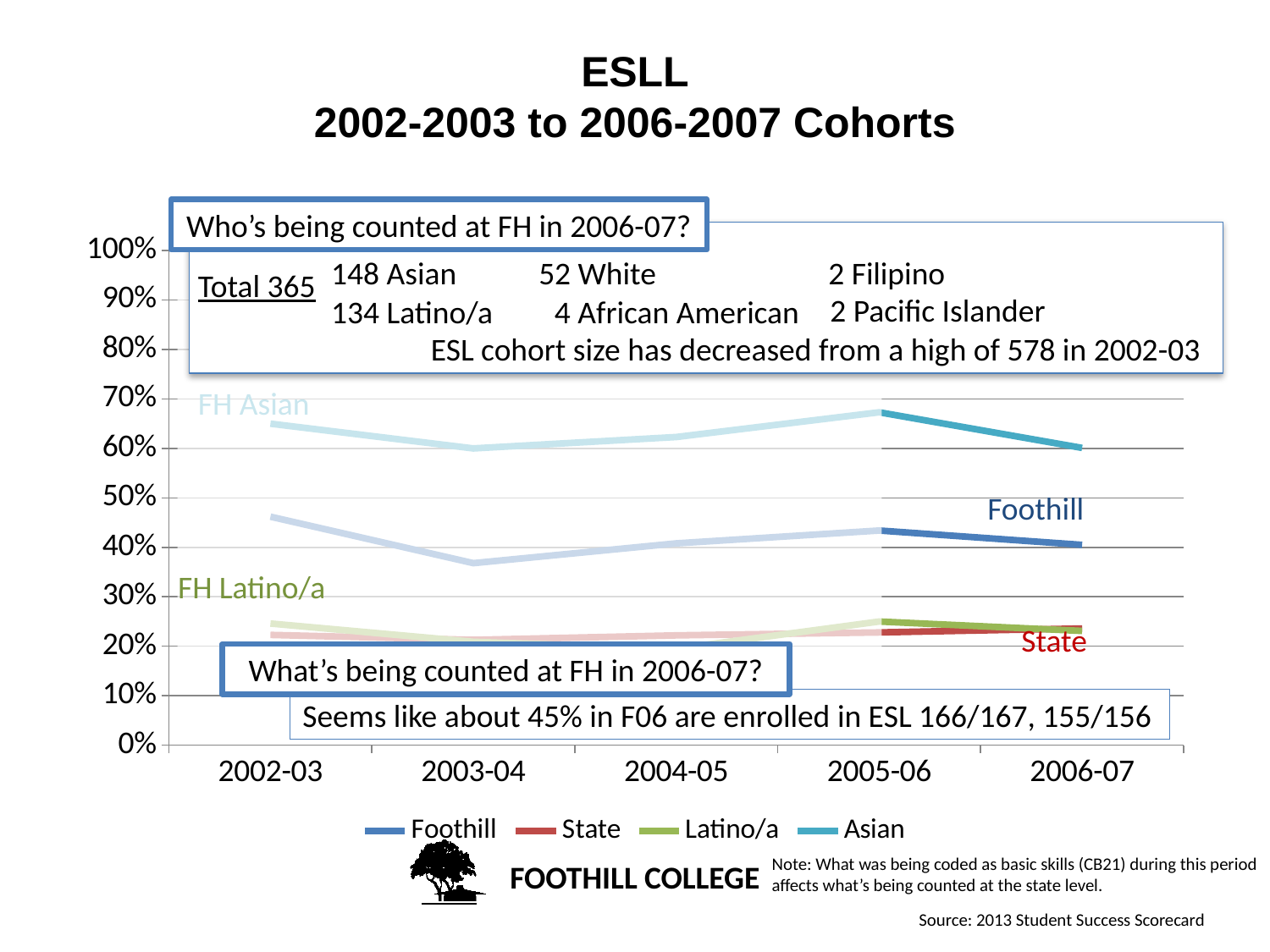
Is the value for Foothill in 2003-04 greater or less than 40%? less Is the value for Foothill in 2002-03 greater or less than 40%? greater Does the Foothill series rise or fall from 2003-04 to 2005-06? rise What are the four entries in the chart legend? Foothill, State, Latino/a, Asian In which cohort year is the Foothill series at its lowest? 2003-04 What kind of chart is shown on the slide? line chart Is the value for Asian in 2002-03 greater or less than 60%? greater How many cohort years are plotted along the x axis? 5 How many series does the legend list? 4 Which series has the highest value in 2002-03? Asian Which is larger in 2006-07, the Foothill value or the State value? Foothill